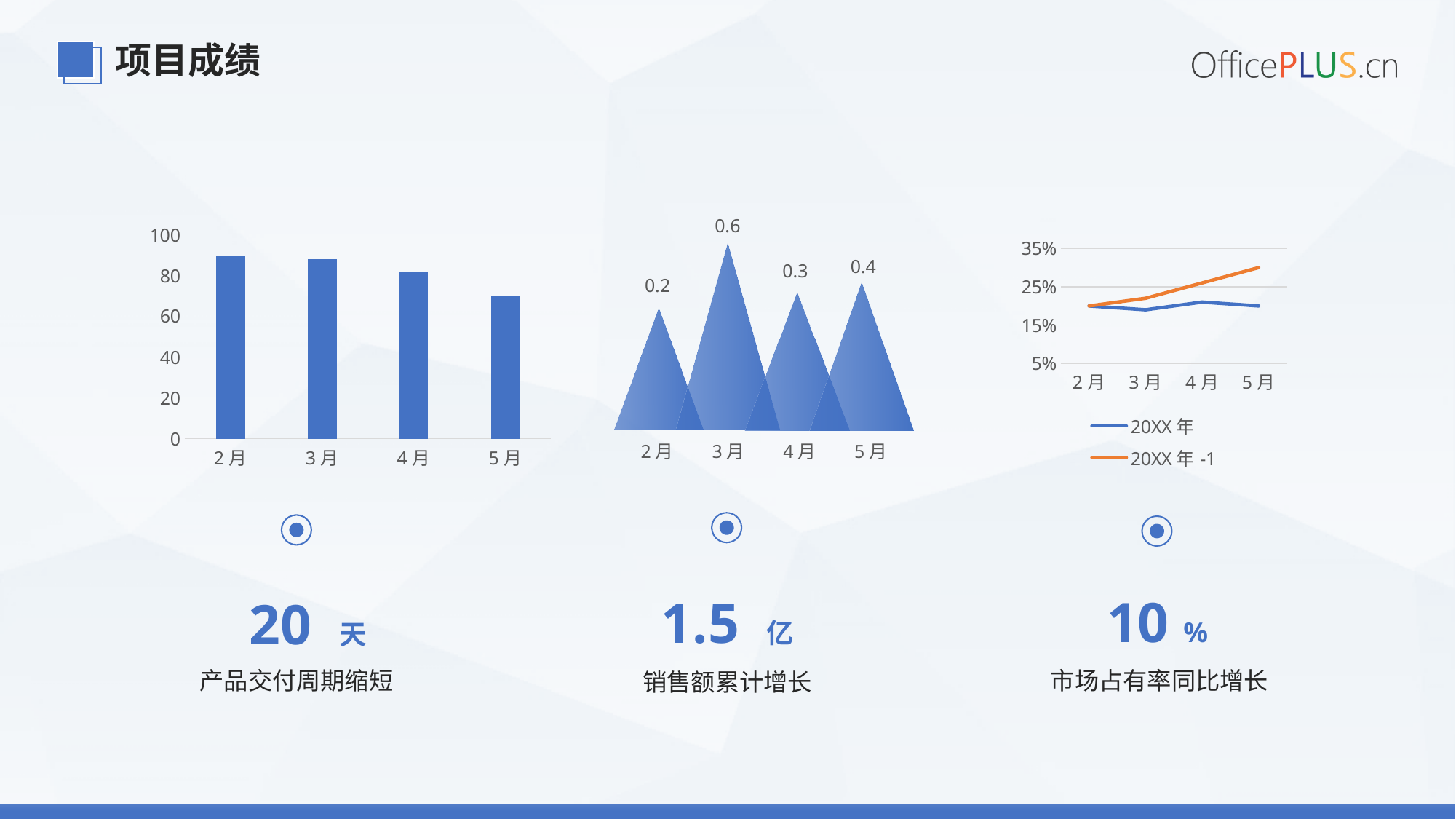
In the right line chart, is the value of 20XX 年 -1 for 5月 greater or less than 25%? greater How many series does the legend of the right line chart list? 2 What kind of chart is the left chart on the slide? bar chart In the left bar chart, is the value for 5月 greater or less than 80? less In the middle chart, which is larger, the value for 4月 or 5月? 5月 In the right line chart, does the 20XX 年 -1 line rise or fall from 2月 to 5月? rise In the left bar chart, which month has the lowest bar? 5月 In the left bar chart, is the value for 2月 greater or less than 80? greater In the middle chart, which month has the lowest value? 2月 In the left bar chart, how many months are shown on the x axis? 4 In the middle chart, what is the value for 3月? 0.6 In the middle chart, what is the difference between the values for 3月 and 2月? 0.4